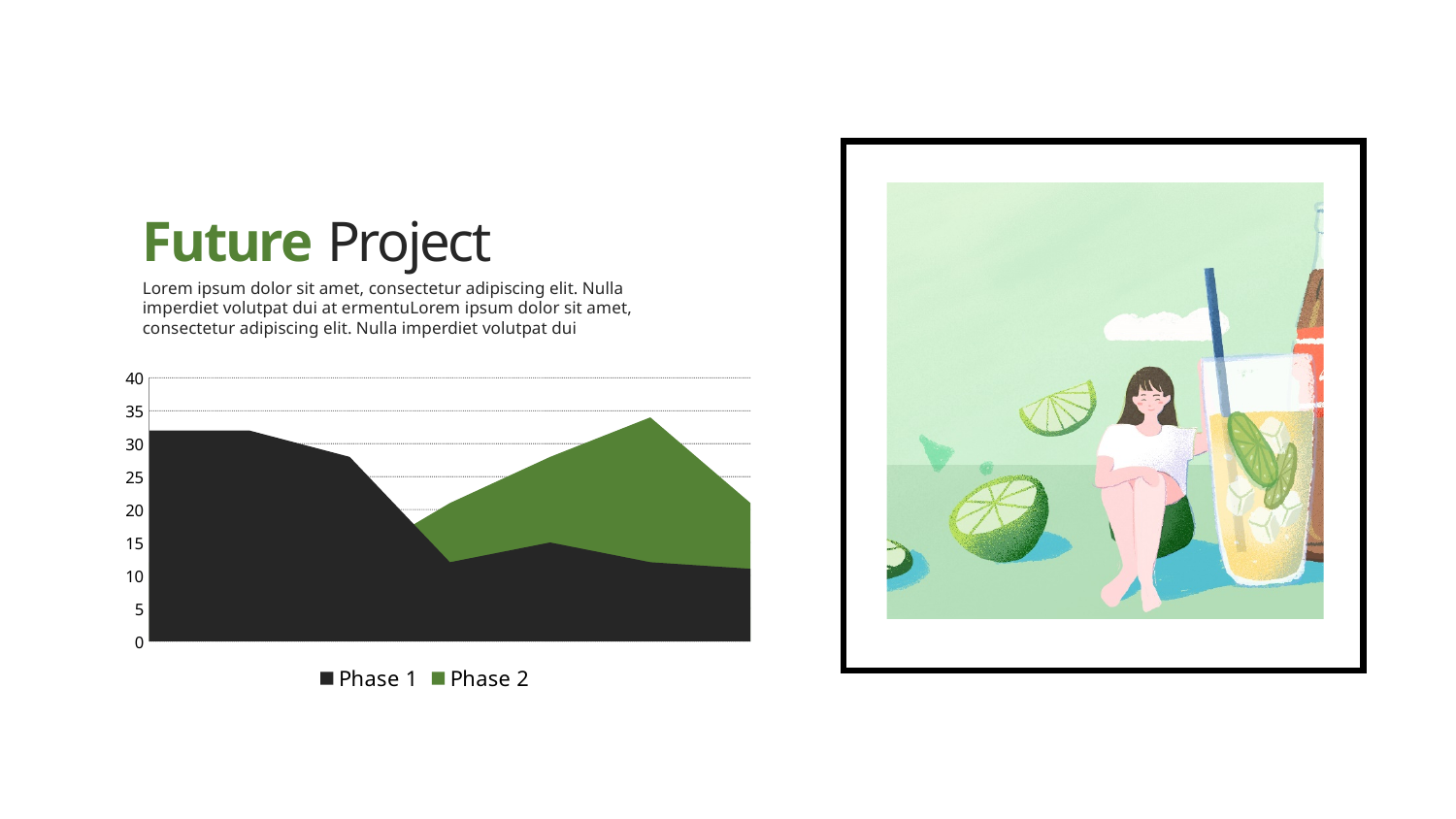
Is the last (rightmost) value of Phase 1 greater or less than 15? less Is the first (leftmost) value of Phase 1 greater or less than 20? greater What are the two series named in the chart legend? Phase 1 and Phase 2 Do the Phase 1 values generally rise or fall from left to right along the x axis? fall Is the highest point of the Phase 2 area greater or less than 30? greater How many series does the chart legend list? 2 What is the highest value shown on the chart's vertical axis? 40 What kind of chart is shown on the slide? area chart